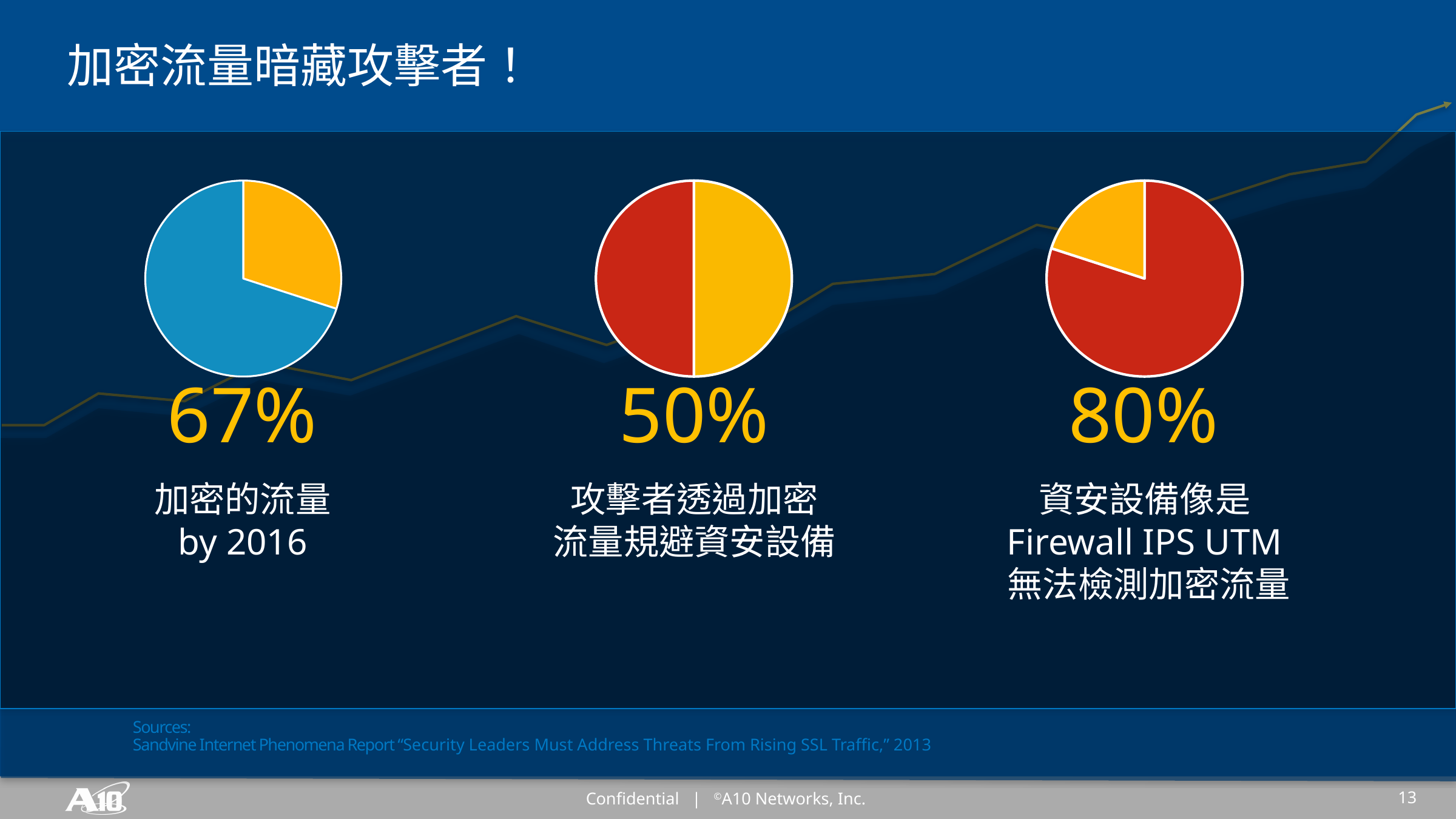
How many pie charts are on the slide? 3 What percentage is shown below the middle pie chart (攻擊者透過加密流量規避資安設備)? 50% Is the percentage shown for the left pie chart larger or smaller than the percentage for the middle pie chart? Larger What colour is the larger slice in the right pie chart? Red Which of the three pie charts shows the lowest percentage? The middle pie chart (50%) How many slices does the middle pie chart have? 2 What is the difference between the percentage of the right pie chart and the left pie chart? 13% Which of the three pie charts shows the highest percentage? The right pie chart (80%) What kind of charts are shown on the slide? Pie charts What percentage is shown below the right pie chart (資安設備像是 Firewall IPS UTM 無法檢測加密流量)? 80% What percentage is shown below the left pie chart (加密的流量 by 2016)? 67% What colour is the larger slice in the left pie chart? Blue